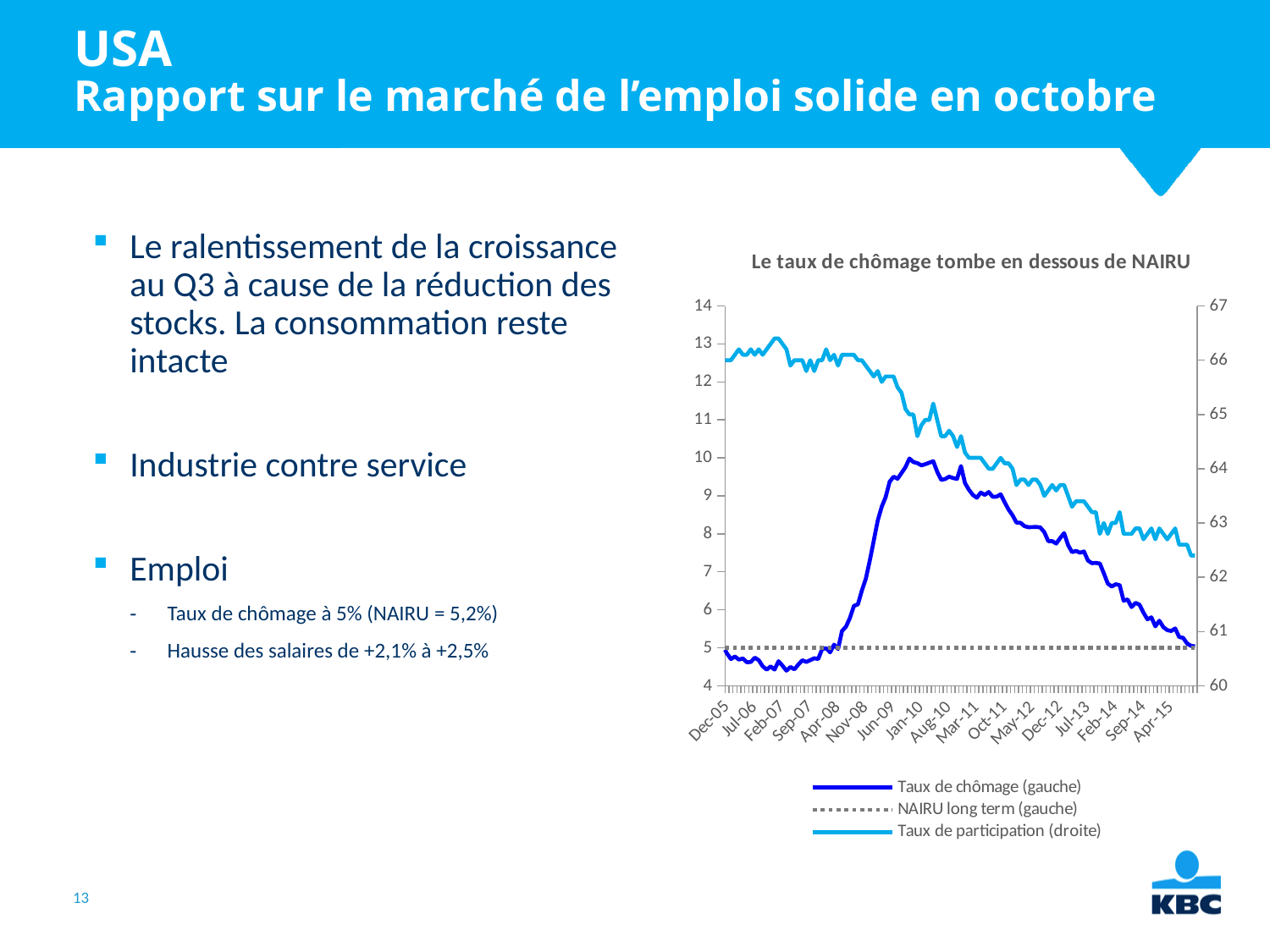
Does the Taux de chômage series rise or fall from Jan-10 to Apr-15? fall Is the value of Taux de participation at the end of the series (around Apr-15) greater or less than 64? less Is the value of Taux de chômage at its peak around Jan-10 greater or less than 9? greater Which is larger at Jan-10: the Taux de chômage value or the NAIRU long term value? Taux de chômage Does the Taux de participation series rise or fall overall from Dec-05 to Apr-15? fall What is the title of the chart? Le taux de chômage tombe en dessous de NAIRU Is the value of Taux de chômage at Dec-05 greater or less than 6? less How many series does the chart legend list? 3 Which series in the chart is plotted against the right-hand axis? Taux de participation (droite) What kind of chart is shown on the slide? line chart